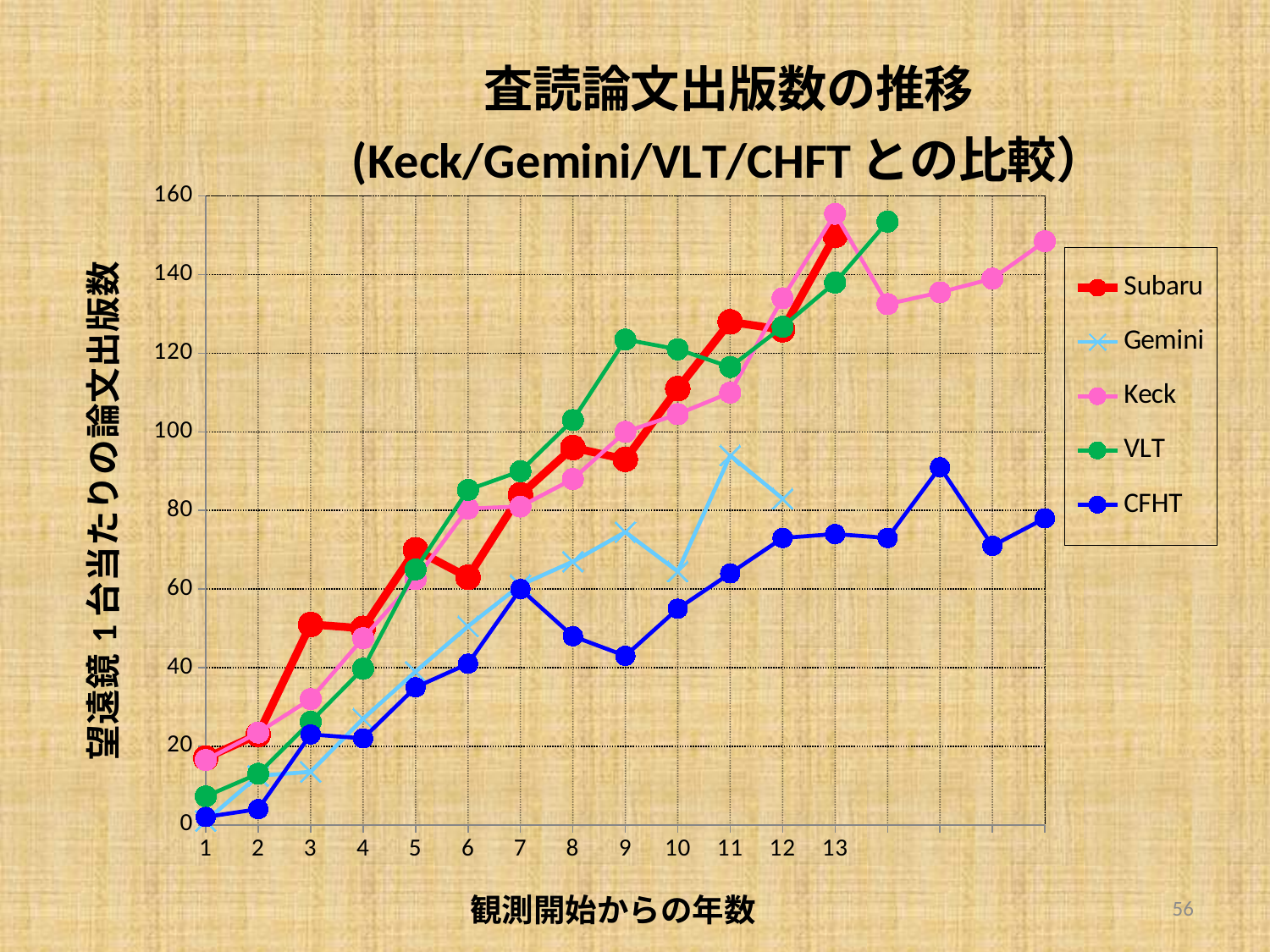
At year 11, which is larger, the value for Subaru or the value for Keck? Subaru Which series are listed in the legend? Subaru, Gemini, Keck, VLT, CFHT Does the Subaru series generally rise or fall from year 1 to year 13? rise Which series has the lowest value at year 13? CFHT Is the value for Keck at year 1 greater or less than 20? less At year 9, which is larger, the value for VLT or the value for Subaru? VLT Is the value for Subaru at year 13 greater or less than 140? greater Is the value for CFHT at year 9 greater or less than 60? less What kind of chart is shown on the slide? line chart How many series does the legend list? 5